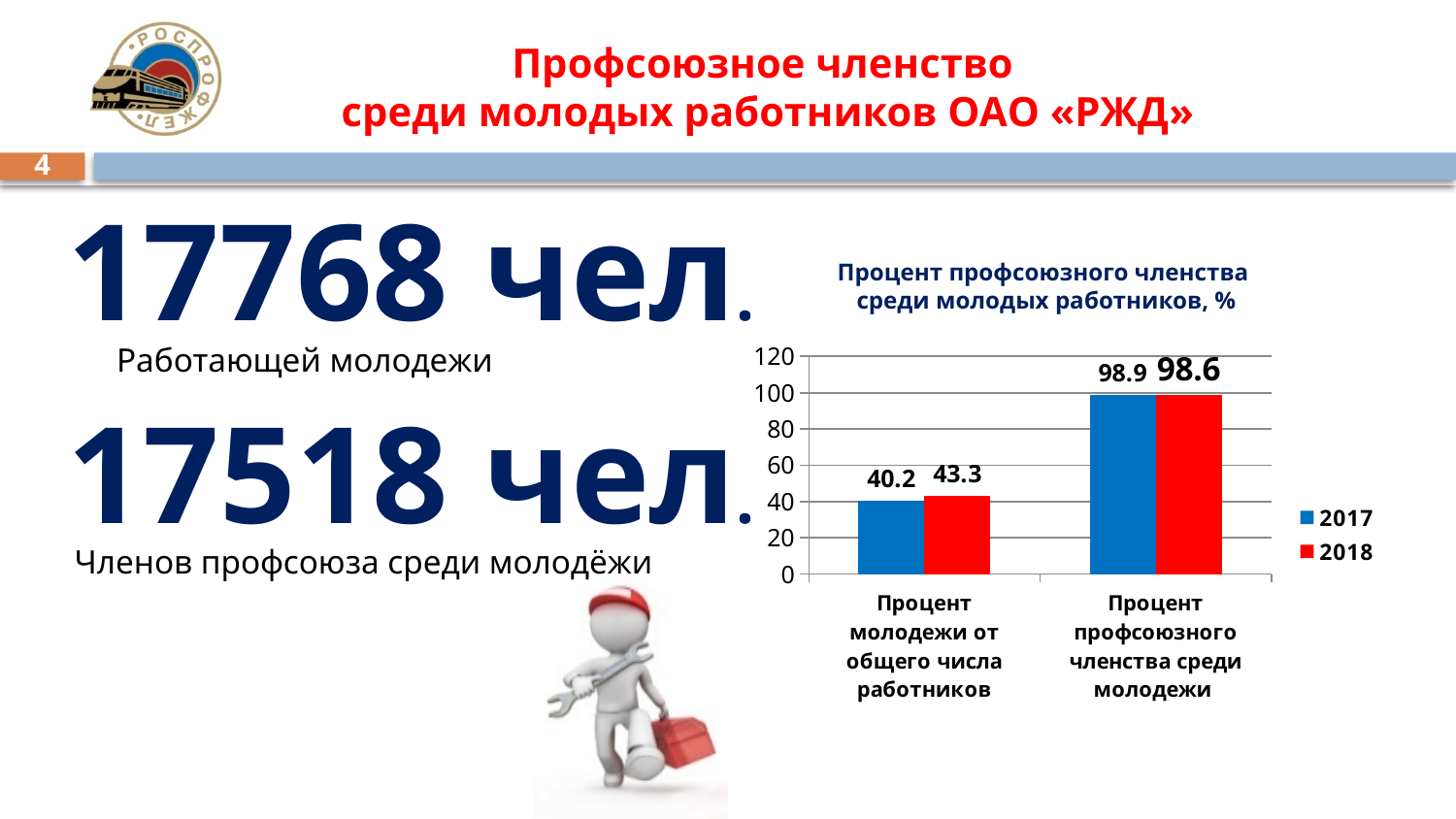
Which category has the lowest 2017 value? Процент молодежи от общего числа работников What is the difference between the 2018 and 2017 values for «Процент молодежи от общего числа работников»? 3.1 What is the 2017 value for «Процент профсоюзного членства среди молодежи»? 98.9 What type of chart is shown on the slide? Bar chart Which category has the highest 2018 value? Процент профсоюзного членства среди молодежи What is the 2018 value for «Процент молодежи от общего числа работников»? 43.3 What is the 2017 value for «Процент молодежи от общего числа работников»? 40.2 How many series does the chart legend list? 2 What is the title of the chart? Процент профсоюзного членства среди молодых работников, % What is the 2018 value for «Процент профсоюзного членства среди молодежи»? 98.6 For «Процент молодежи от общего числа работников», which year has the larger value, 2017 or 2018? 2018 How many categories are shown on the x axis of the chart? 2